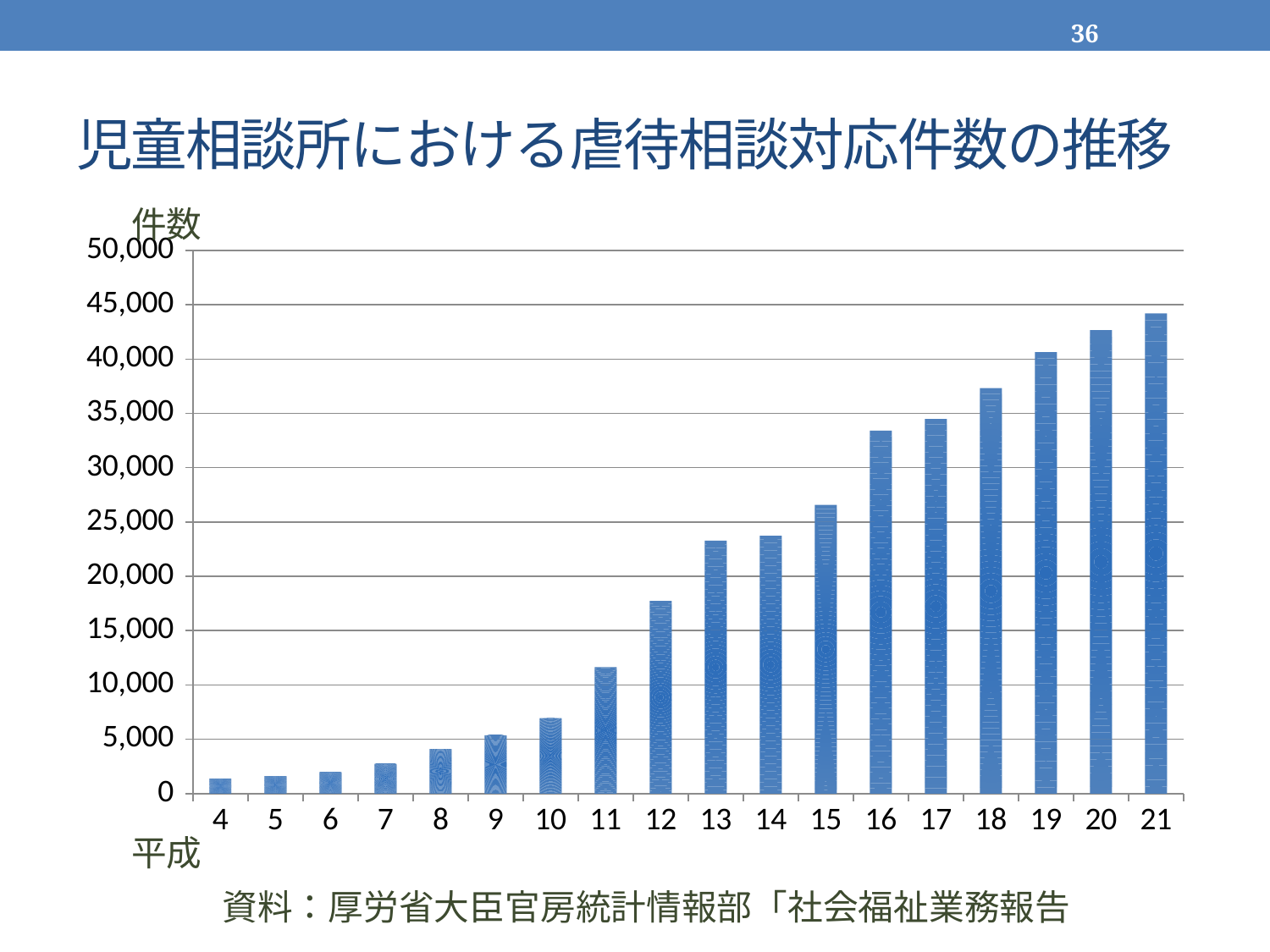
Which year (平成) has the lowest number of cases? 4 Is the value for 平成16 greater or less than 30,000? greater Is the value for 平成10 greater or less than 10,000? less Which year (平成) has the highest number of cases? 21 How many years (bars) are plotted on the chart? 18 What kind of chart is shown on the slide? bar chart Do the values generally rise or fall from 平成4 to 平成21? rise Which is larger, the value for 平成15 or the value for 平成13? 平成15 Is the value for 平成21 greater or less than 40,000? greater What is the label on the vertical axis of the chart? 件数 What is the title of the chart on the slide? 児童相談所における虐待相談対応件数の推移